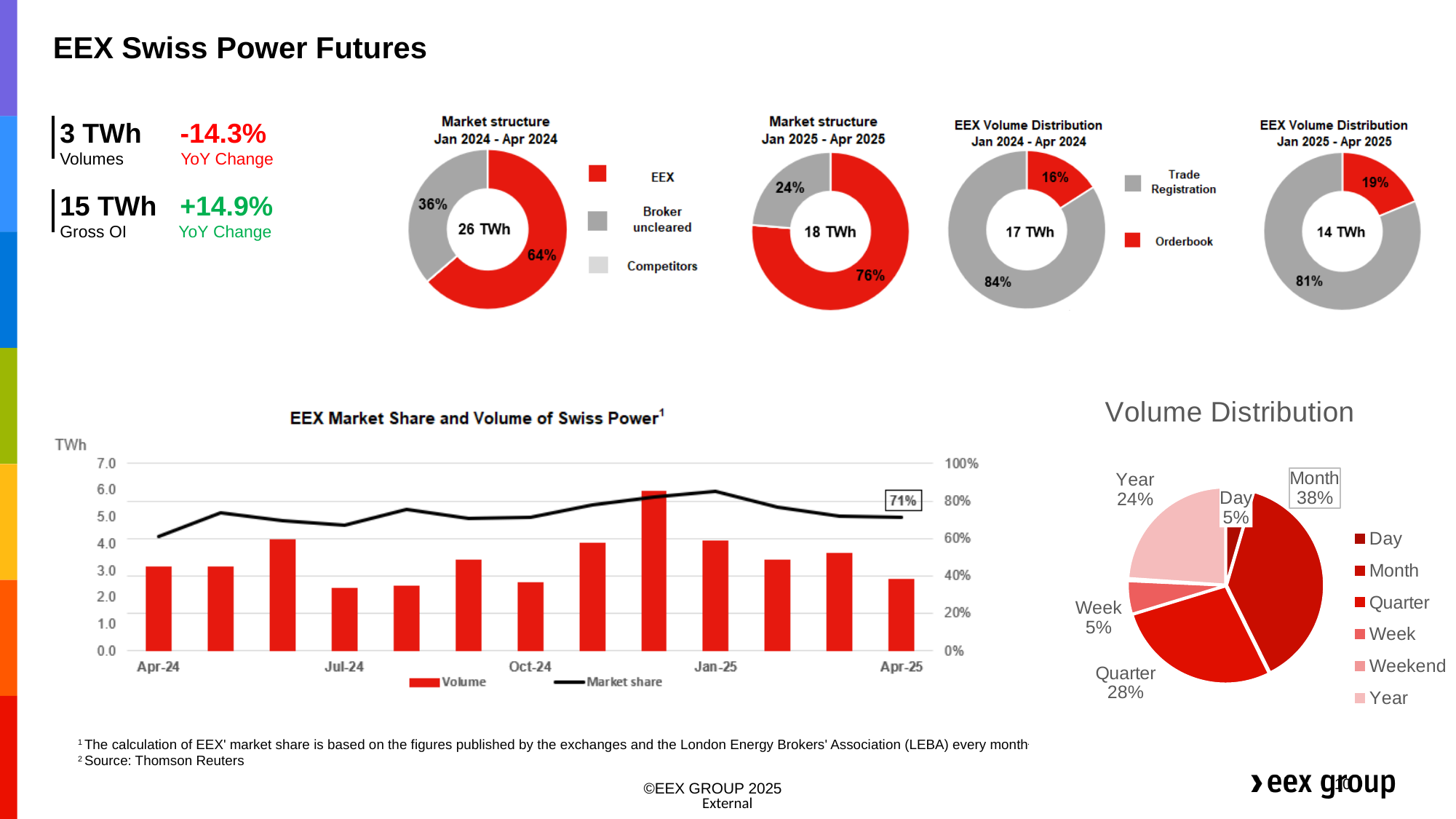
In the Market structure Jan 2025 - Apr 2025 donut chart, what share is Broker uncleared? 24% In the EEX Market Share and Volume of Swiss Power chart, is the volume for Jan-25 greater or less than 5.0 TWh? less By how many percentage points did the Orderbook share in the EEX Volume Distribution charts change from Jan 2024 - Apr 2024 to Jan 2025 - Apr 2025? 3 percentage points In the Market structure Jan 2024 - Apr 2024 donut chart, what share does EEX hold? 64% In the EEX Volume Distribution Jan 2024 - Apr 2024 donut chart, what share is Orderbook? 16% How many entries does the legend of the Volume Distribution pie chart list? 6 In the Volume Distribution pie chart, what share does Quarter have? 28% In the EEX Market Share and Volume of Swiss Power chart, what market share is labelled for Apr-25? 71% In the Volume Distribution pie chart, which category has the largest share? Month In the EEX Market Share and Volume of Swiss Power chart, which month has the highest volume bar? Dec-24 In the EEX Volume Distribution Jan 2025 - Apr 2025 donut chart, what share is Trade Registration? 81% What total volume is shown in the centre of the Market structure Jan 2025 - Apr 2025 donut chart? 18 TWh